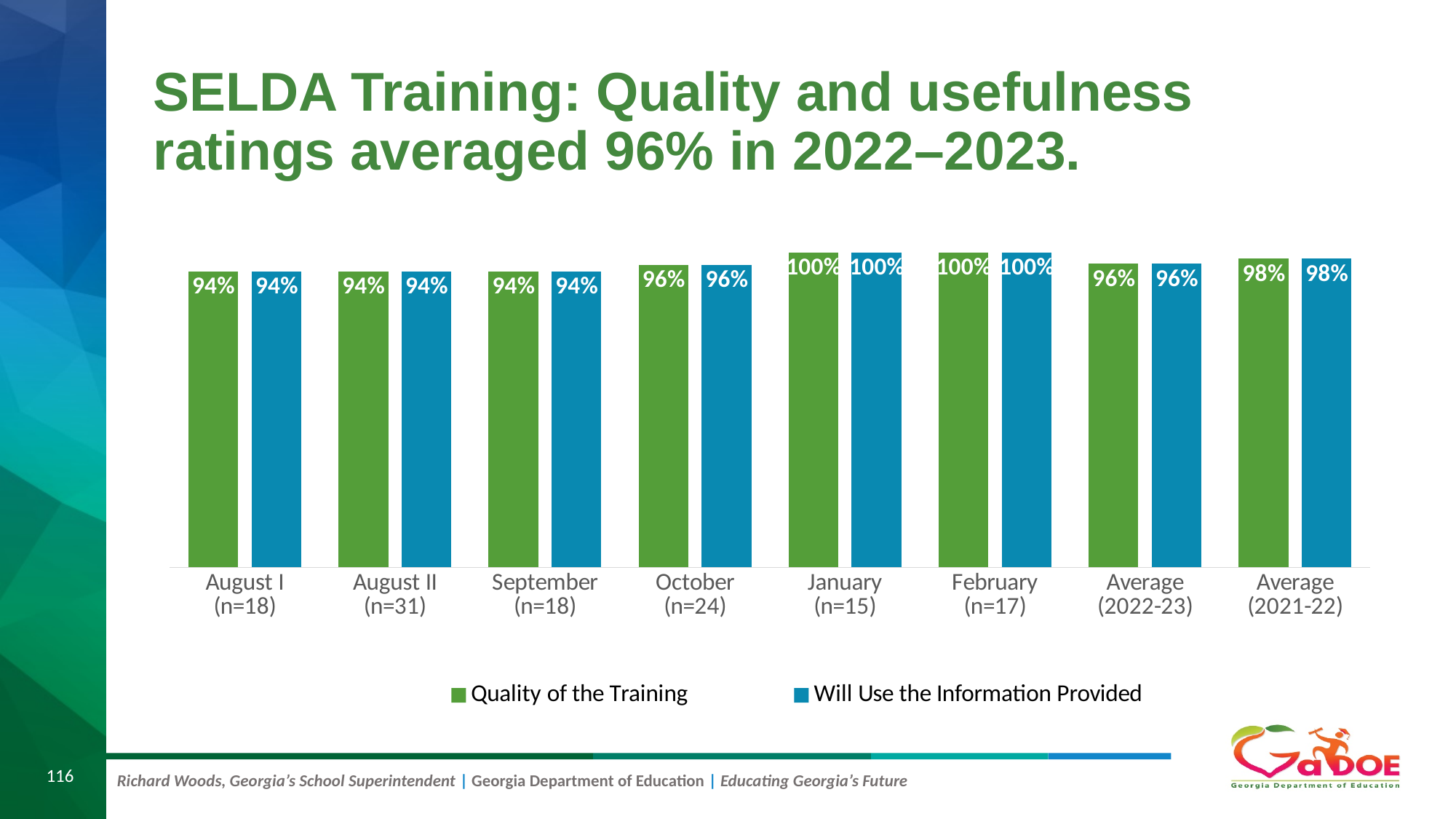
How many series does the legend list? 2 How many categories are shown on the x axis? 8 Which is larger: the Quality of the Training value for October (n=24) or for August I (n=18)? October (n=24) Which categories have the highest Quality of the Training value? January (n=15) and February (n=17) What kind of chart is shown on the slide? Bar chart What is the Will Use the Information Provided value for Average (2022-23)? 96% What is the Will Use the Information Provided value for August II (n=31)? 94% What is the difference between the Quality of the Training value for January (n=15) and for September (n=18)? 6% What is the difference between the Will Use the Information Provided value for Average (2021-22) and Average (2022-23)? 2% Which series is shown in blue in the legend? Will Use the Information Provided What is the Quality of the Training value for October (n=24)? 96% What is the Quality of the Training value for Average (2021-22)? 98%